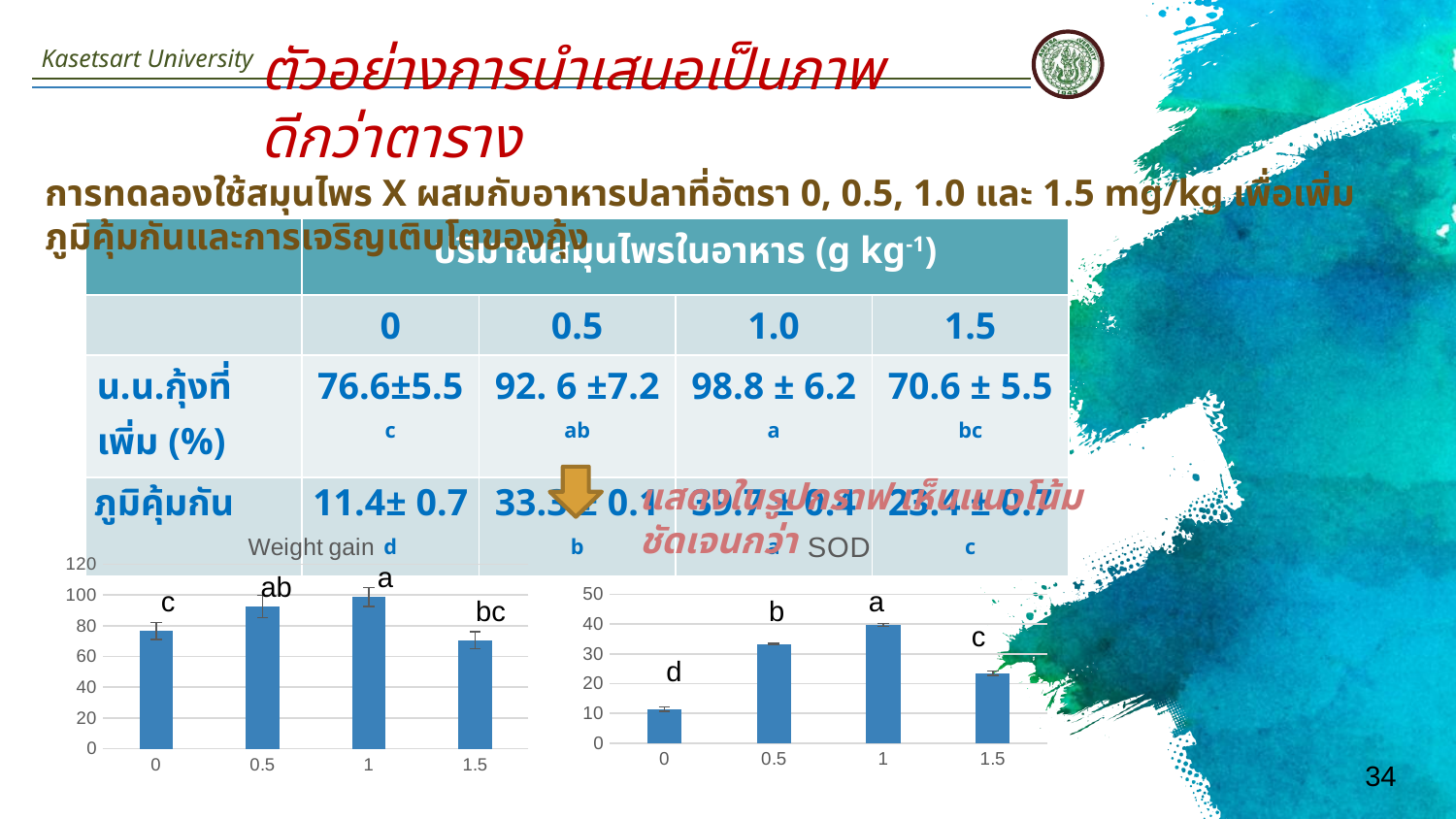
In the SOD chart, which category has the lowest bar? 0 In the SOD chart, which is larger, the bar for 0.5 or the bar for 1.5? 0.5 In the Weight gain chart, which category has the highest bar? 1 In the Weight gain chart, what letter is printed above the bar for category 1? a In the SOD chart, is the value for category 1 greater or less than 30? greater In the Weight gain chart, is the value for category 1.5 greater or less than 80? less What kind of chart is the Weight gain chart on the left? bar chart In the SOD chart, which category has the highest bar? 1 In the Weight gain chart, which category has the lowest bar? 1.5 In the Weight gain chart, is the value for category 0 greater or less than 60? greater How many categories are shown on the x axis of the SOD chart? 4